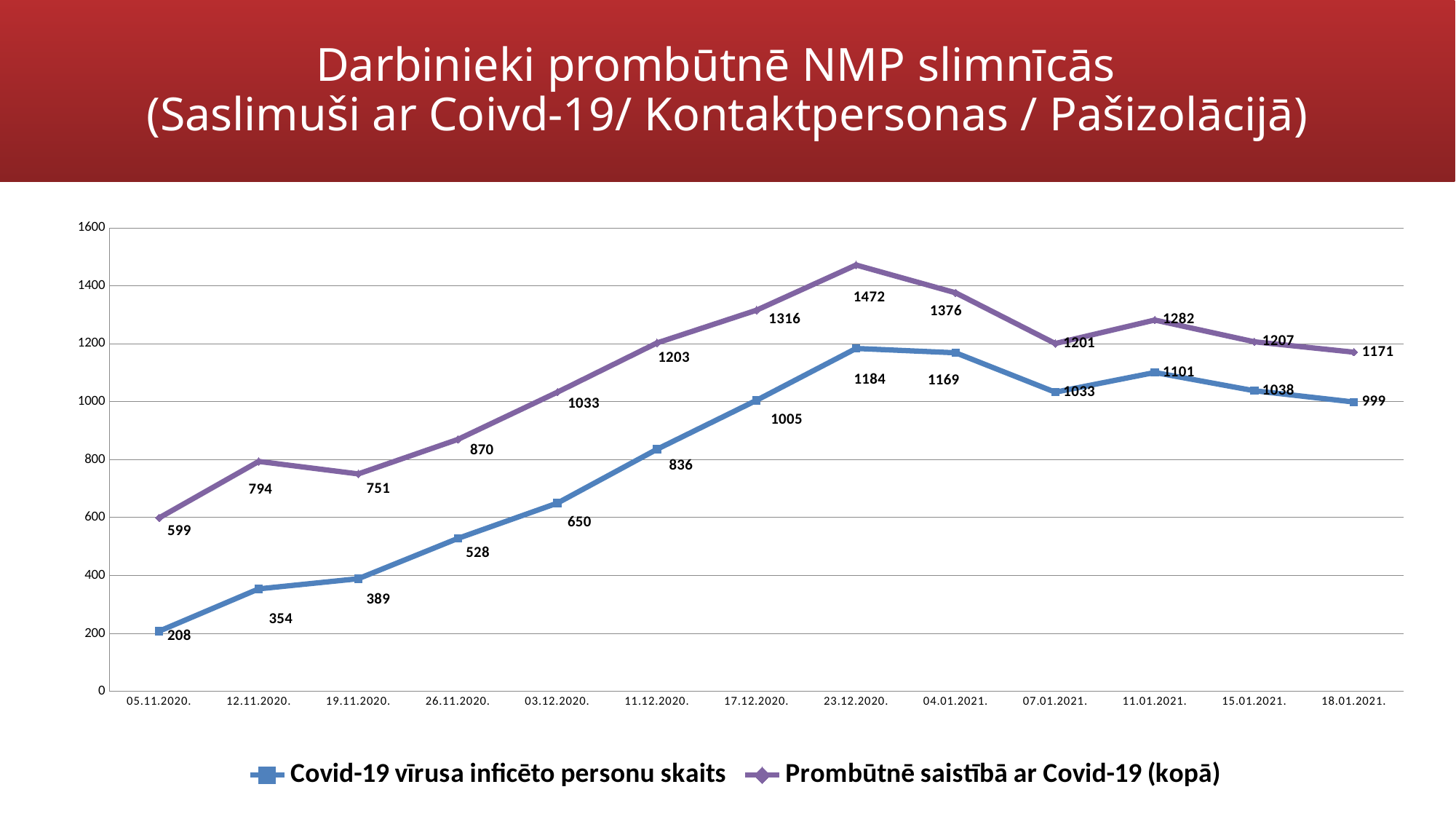
What type of chart is shown on the slide? line chart What is the value of 'Covid-19 vīrusa inficēto personu skaits' on 05.11.2020.? 208 Does 'Covid-19 vīrusa inficēto personu skaits' rise or fall between 05.11.2020. and 23.12.2020.? rise What is the difference between 'Prombūtnē saistībā ar Covid-19 (kopā)' and 'Covid-19 vīrusa inficēto personu skaits' on 11.12.2020.? 367 On which date is 'Prombūtnē saistībā ar Covid-19 (kopā)' lowest? 05.11.2020. How many series does the legend list? 2 What is the value of 'Prombūtnē saistībā ar Covid-19 (kopā)' on 23.12.2020.? 1472 On which date does 'Covid-19 vīrusa inficēto personu skaits' reach its highest value? 23.12.2020. Which series is drawn in purple? Prombūtnē saistībā ar Covid-19 (kopā) Which is larger: 'Prombūtnē saistībā ar Covid-19 (kopā)' on 11.01.2021. or on 15.01.2021.? 11.01.2021. How many dates are plotted along the x axis? 13 What is the value of 'Covid-19 vīrusa inficēto personu skaits' on 18.01.2021.? 999